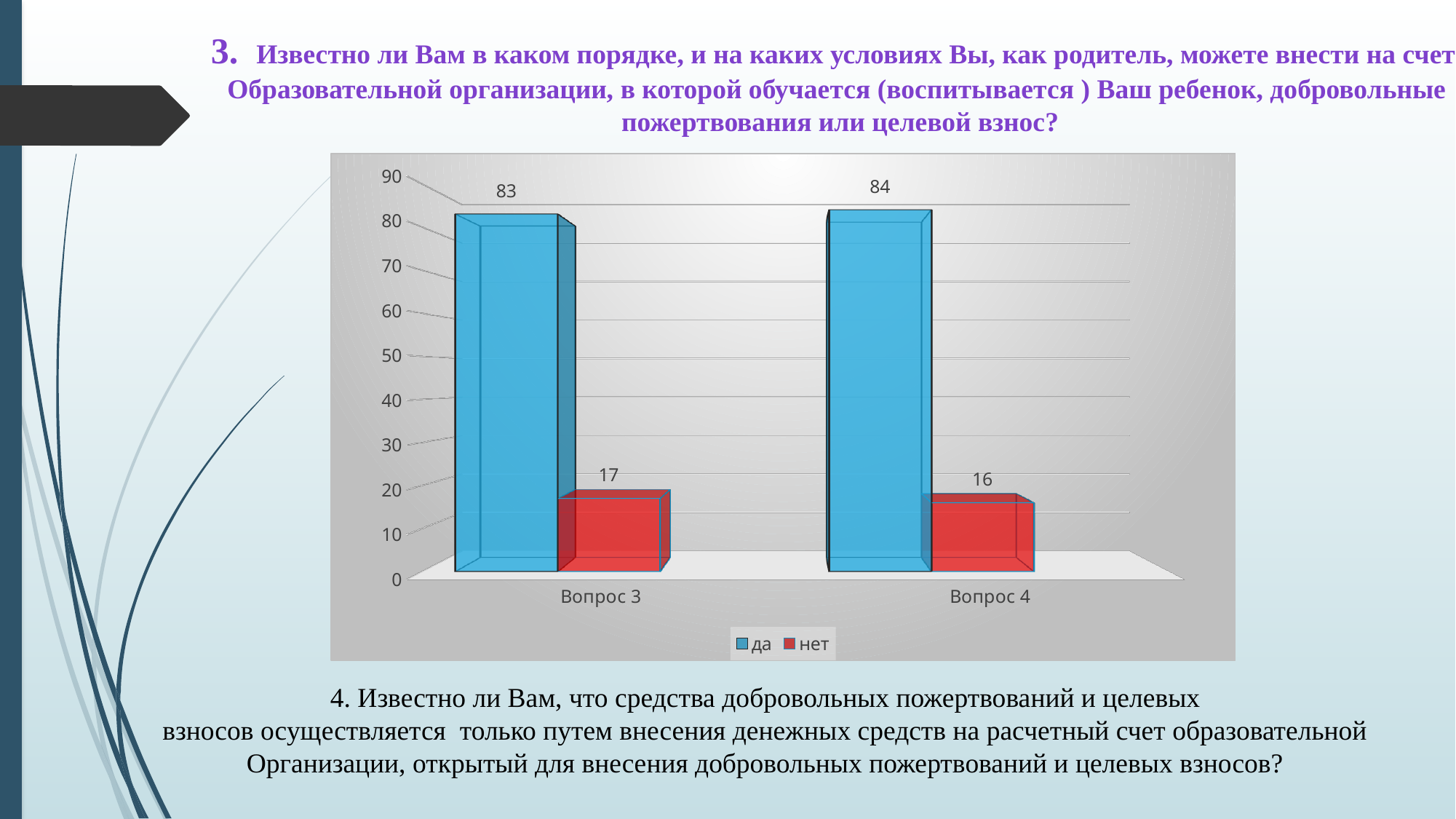
What kind of chart is shown on the slide? bar chart What is the value for "да" for Вопрос 4? 84 How many series does the legend list? 2 Which category has the highest value for "нет"? Вопрос 3 What is the difference between the "да" and "нет" values for Вопрос 3? 66 How many categories are shown on the x axis? 2 Which is larger for Вопрос 4: the "да" value or the "нет" value? да What is the value for "да" for Вопрос 3? 83 Is the value for "нет" for Вопрос 3 greater or less than 20? less What is the difference between the "да" and "нет" values for Вопрос 4? 68 What is the value for "нет" for Вопрос 4? 16 What is the value for "нет" for Вопрос 3? 17